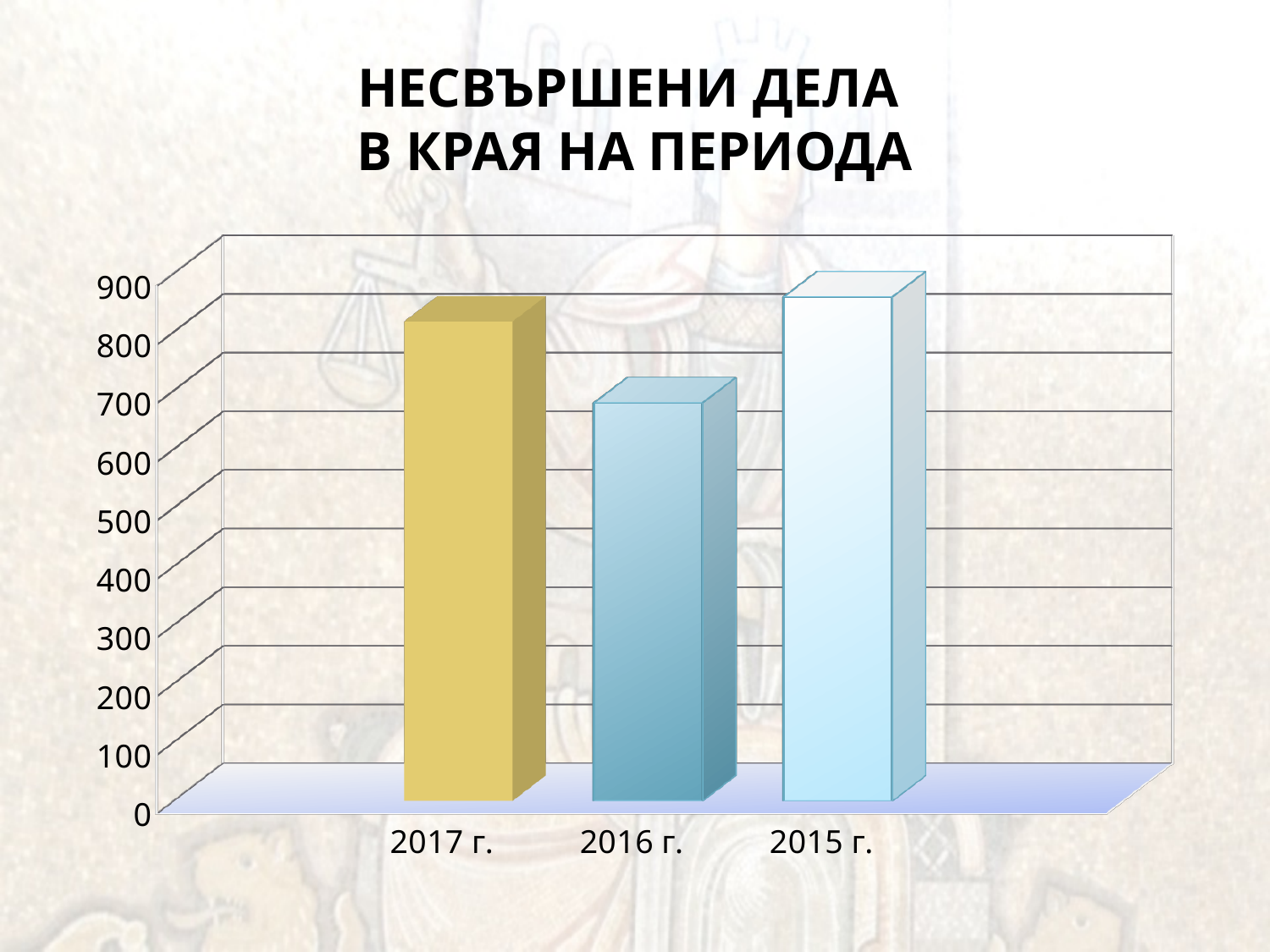
Is the value for 2016 г. greater or less than 800? less Which is larger, the value for 2015 г. or the value for 2016 г.? 2015 г. Which year has the highest value in the chart? 2015 г. Is the value for 2015 г. greater or less than 700? greater How many categories (years) are plotted in the chart? 3 What kind of chart is shown on the slide? bar chart Is the value for 2016 г. greater or less than 600? greater Moving from 2017 г. to 2016 г. along the x axis, does the value rise or fall? fall Which is larger, the value for 2017 г. or the value for 2016 г.? 2017 г. What is the title of the chart? НЕСВЪРШЕНИ ДЕЛА В КРАЯ НА ПЕРИОДА Which year has the lowest value in the chart? 2016 г.